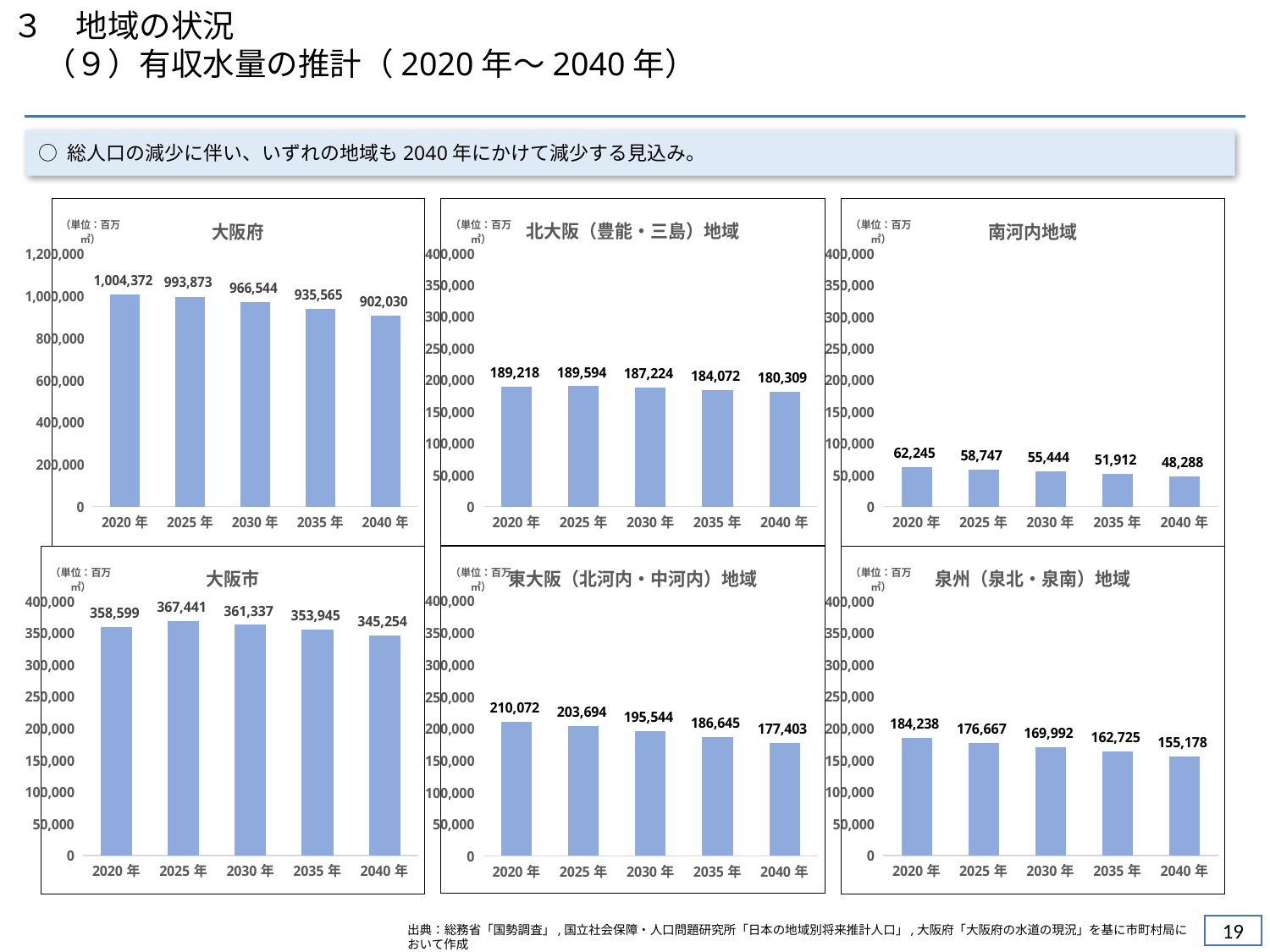
In the 泉州（泉北・泉南）地域 chart, do the values rise or fall from 2020年 to 2040年? fall In the 大阪市 chart, is the value for 2040年 greater or less than 300,000? greater In the 北大阪（豊能・三島）地域 chart, what is the value for 2035年? 184,072 In the 東大阪（北河内・中河内）地域 chart, what is the difference between the 2020年 and 2040年 values? 32,669 What kind of chart is the 大阪府 chart? bar chart In the 大阪府 chart, what is the value for 2020年? 1,004,372 In the 泉州（泉北・泉南）地域 chart, which year has the lowest value? 2040年 In the 北大阪（豊能・三島）地域 chart, which is larger, the value for 2020年 or 2025年? 2025年 How many charts are shown on the slide? 6 In the 大阪市 chart, which year has the highest value? 2025年 How many years are plotted in the 南河内地域 chart? 5 In the 南河内地域 chart, what is the value for 2040年? 48,288